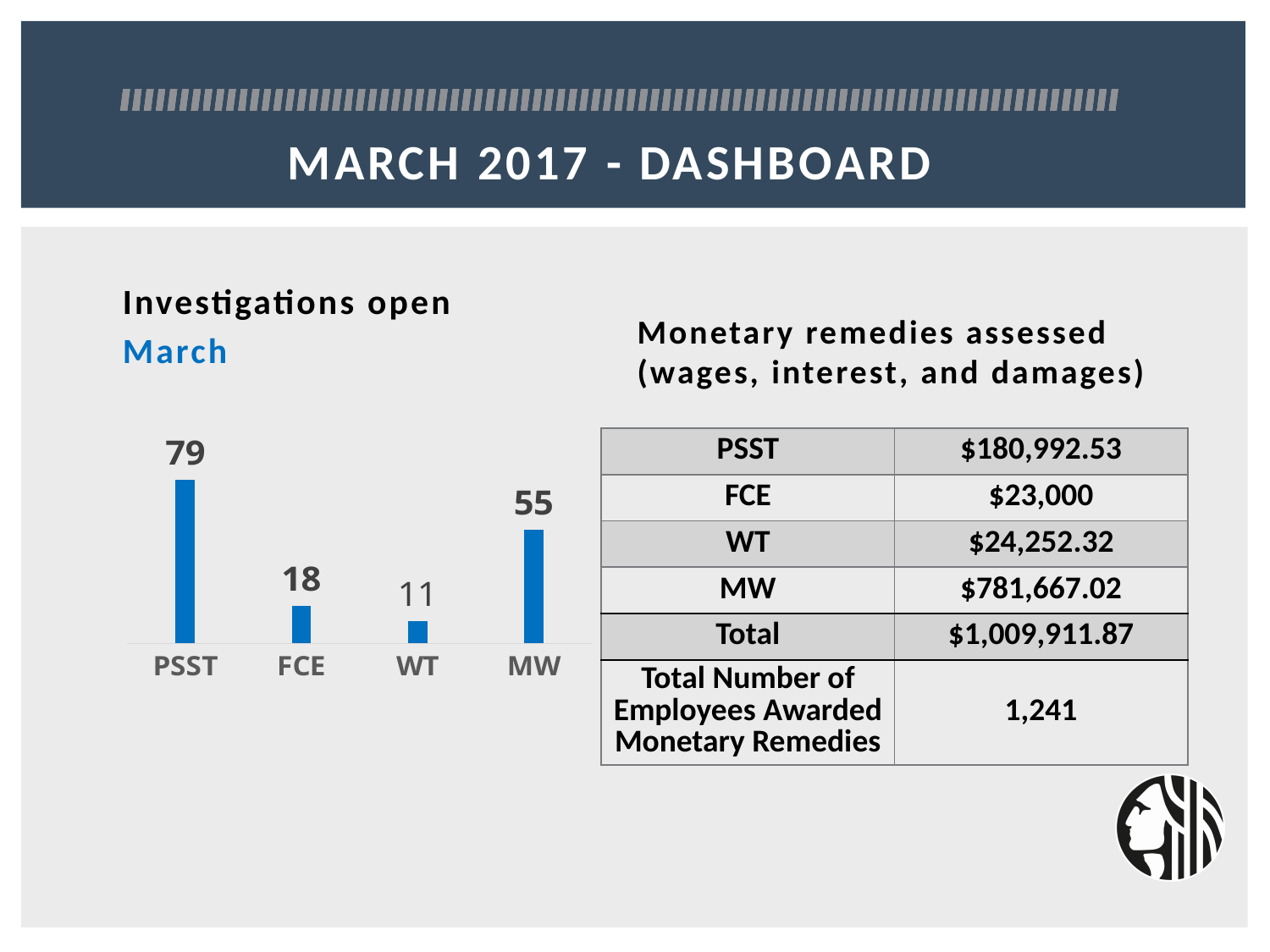
What is the difference between the PSST and MW values in the Investigations open chart? 24 What is the value for WT in the Investigations open chart? 11 What month is shown as the subtitle of the Investigations open chart? March What is the value for PSST in the Investigations open chart? 79 What is the difference between the FCE and WT values in the Investigations open chart? 7 Which category has the highest value in the Investigations open chart? PSST In the Investigations open chart, which is larger, FCE or MW? MW What kind of chart is the Investigations open chart? bar chart Which category has the lowest value in the Investigations open chart? WT What is the value for FCE in the Investigations open chart? 18 What is the value for MW in the Investigations open chart? 55 How many categories are shown in the Investigations open chart? 4